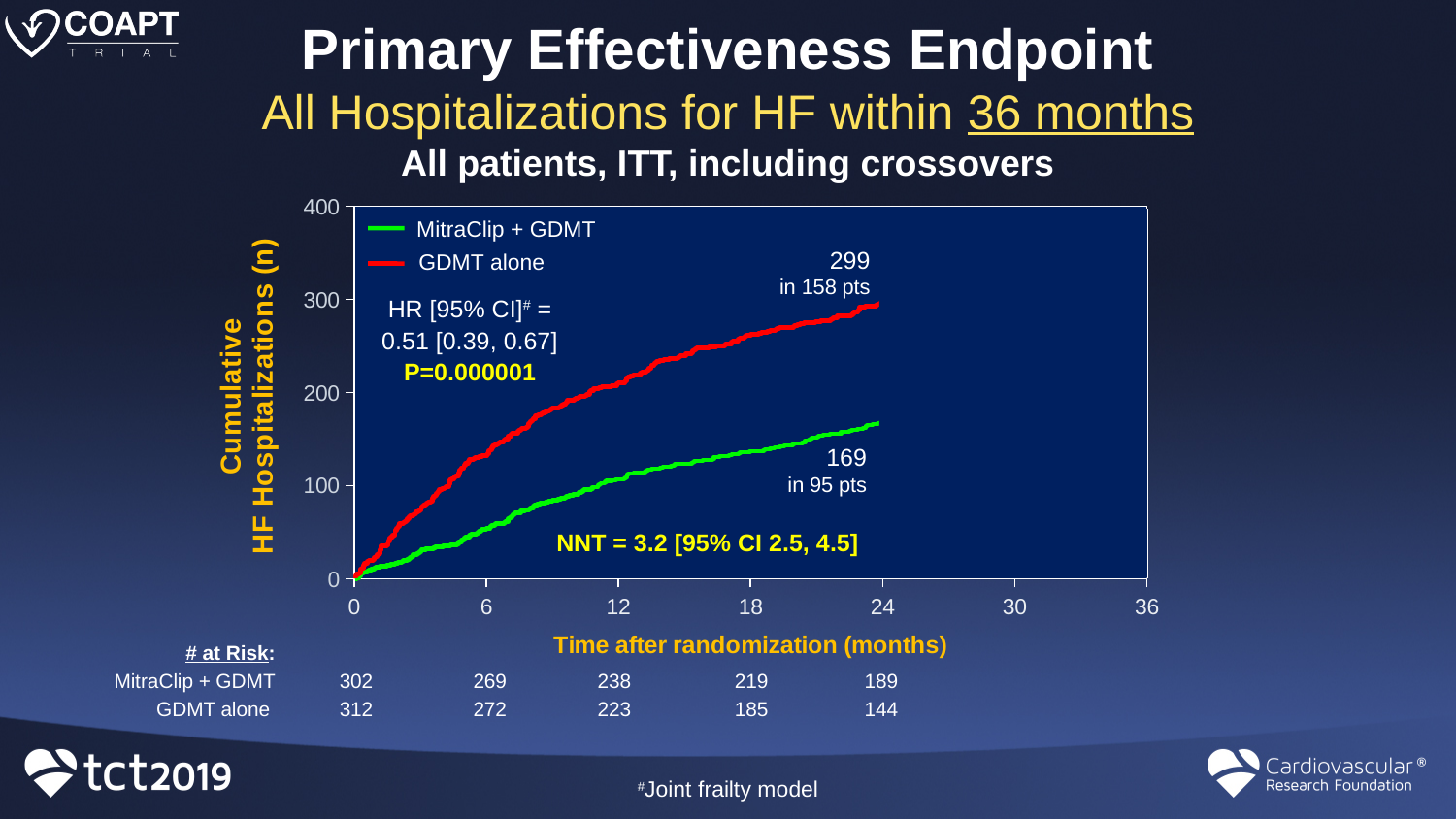
What is the hazard ratio with 95% CI shown on the chart? 0.51 [0.39, 0.67] What is the final cumulative number of HF hospitalizations for the GDMT alone group? 299 Which colour represents the MitraClip + GDMT series? Green What is the number at risk for the GDMT alone group at 24 months? 144 In how many patients did the 299 HF hospitalizations in the GDMT alone group occur? 158 pts Do the cumulative HF hospitalization curves rise or fall over time after randomization? Rise Is the final cumulative value for the MitraClip + GDMT curve greater or less than 200? less What type of chart is shown on the slide? Line chart Which group has the higher cumulative number of HF hospitalizations at the end of follow-up? GDMT alone What is the final cumulative number of HF hospitalizations for the MitraClip + GDMT group? 169 What is the difference between the final cumulative HF hospitalizations of the GDMT alone group and the MitraClip + GDMT group? 130 How many series does the legend list? 2